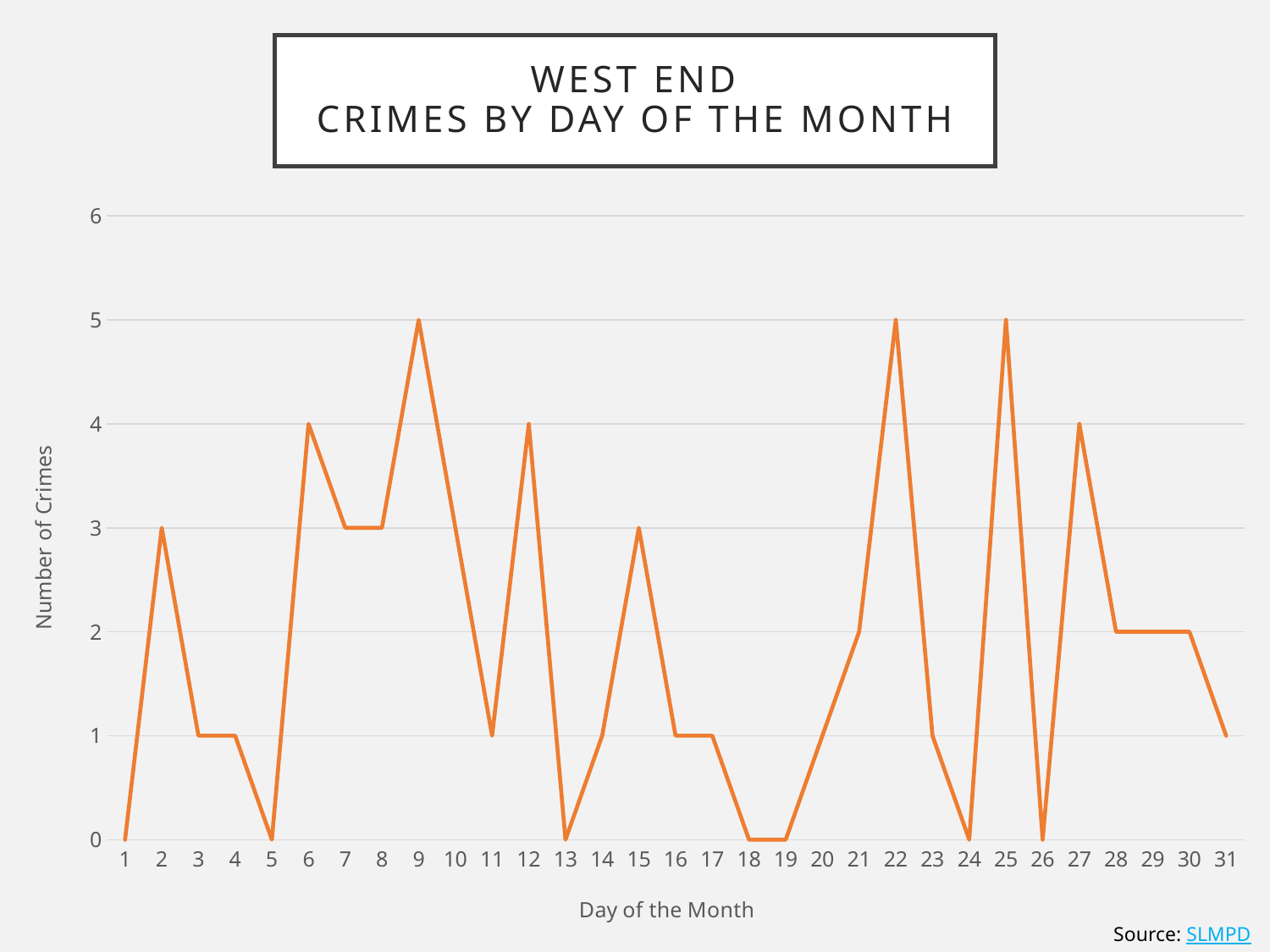
What is the highest number of crimes recorded on any single day? 5 What kind of chart is shown on the slide? Line chart What is the number of crimes on day 21? 2 What is the difference in the number of crimes between day 22 and day 23? 4 What is the title of the chart? West End Crimes by Day of the Month What is the number of crimes on day 31? 1 Do the values rise or fall from day 27 to day 28? Fall What is the number of crimes on day 6? 4 How many days are plotted along the x axis? 31 What is the number of crimes on day 9? 5 Which day has more crimes, day 2 or day 3? Day 2 What is the lowest number of crimes recorded on any single day? 0